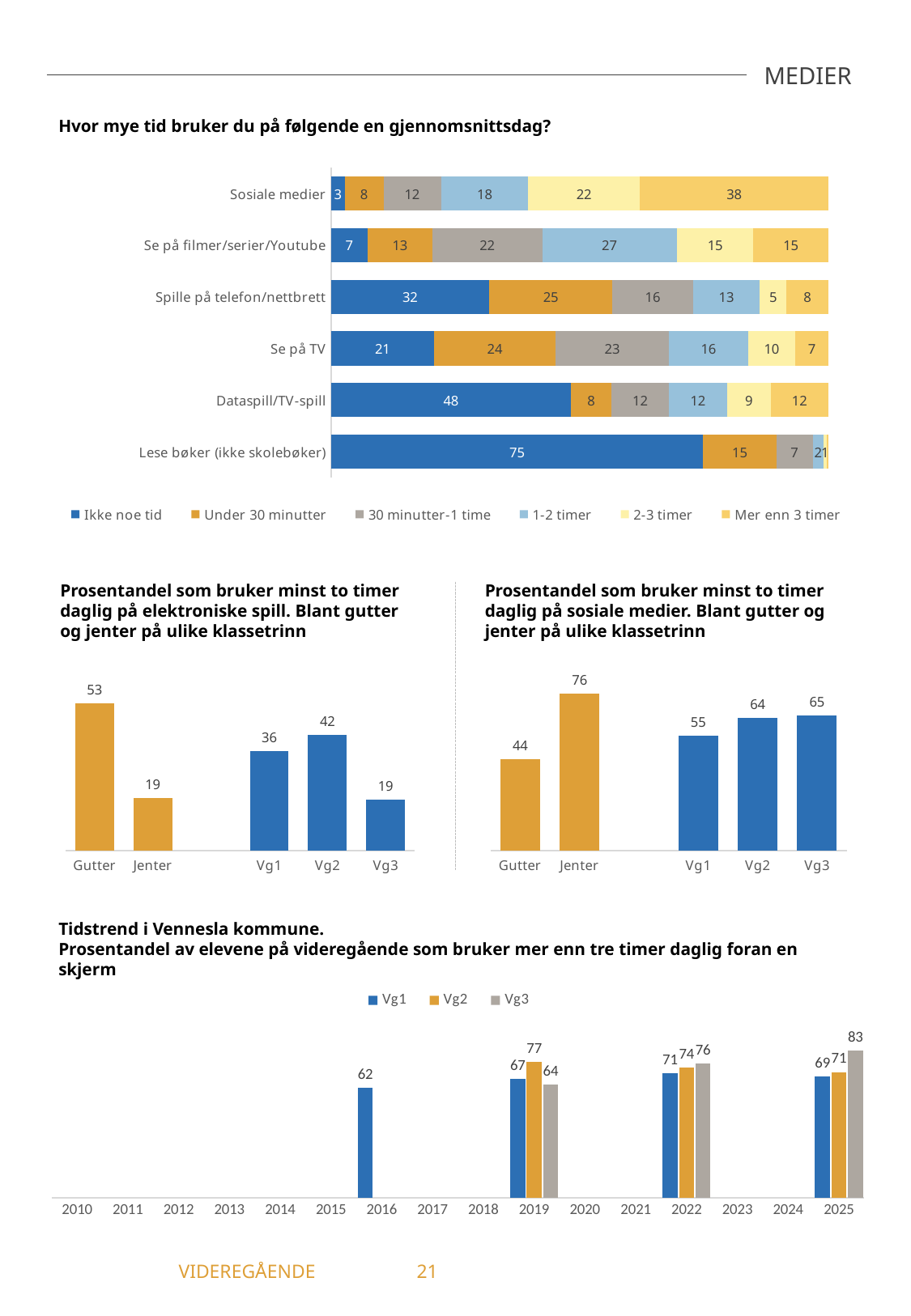
In the chart 'Prosentandel som bruker minst to timer daglig på sosiale medier', which category has the highest value? Jenter In the chart 'Hvor mye tid bruker du på følgende en gjennomsnittsdag?', what is the value for 'Ikke noe tid' for Lese bøker (ikke skolebøker)? 75 In the chart 'Hvor mye tid bruker du på følgende en gjennomsnittsdag?', which category has the highest value for 'Ikke noe tid'? Lese bøker (ikke skolebøker) In the chart 'Prosentandel som bruker minst to timer daglig på sosiale medier', what is the value for Vg2? 64 In the chart 'Tidstrend i Vennesla kommune', what is the value for Vg3 in 2025? 83 In the chart 'Hvor mye tid bruker du på følgende en gjennomsnittsdag?', what is the value for 'Mer enn 3 timer' for Sosiale medier? 38 In the chart 'Tidstrend i Vennesla kommune', which is larger in 2019: Vg1 or Vg2? Vg2 In the chart 'Hvor mye tid bruker du på følgende en gjennomsnittsdag?', how many activity categories are shown? 6 In the chart 'Prosentandel som bruker minst to timer daglig på elektroniske spill', what is the difference between Gutter and Jenter? 34 In the chart 'Hvor mye tid bruker du på følgende en gjennomsnittsdag?', how many series does the legend list? 6 In the chart 'Prosentandel som bruker minst to timer daglig på elektroniske spill', what is the value for Gutter? 53 What kind of chart is 'Tidstrend i Vennesla kommune'? Bar chart